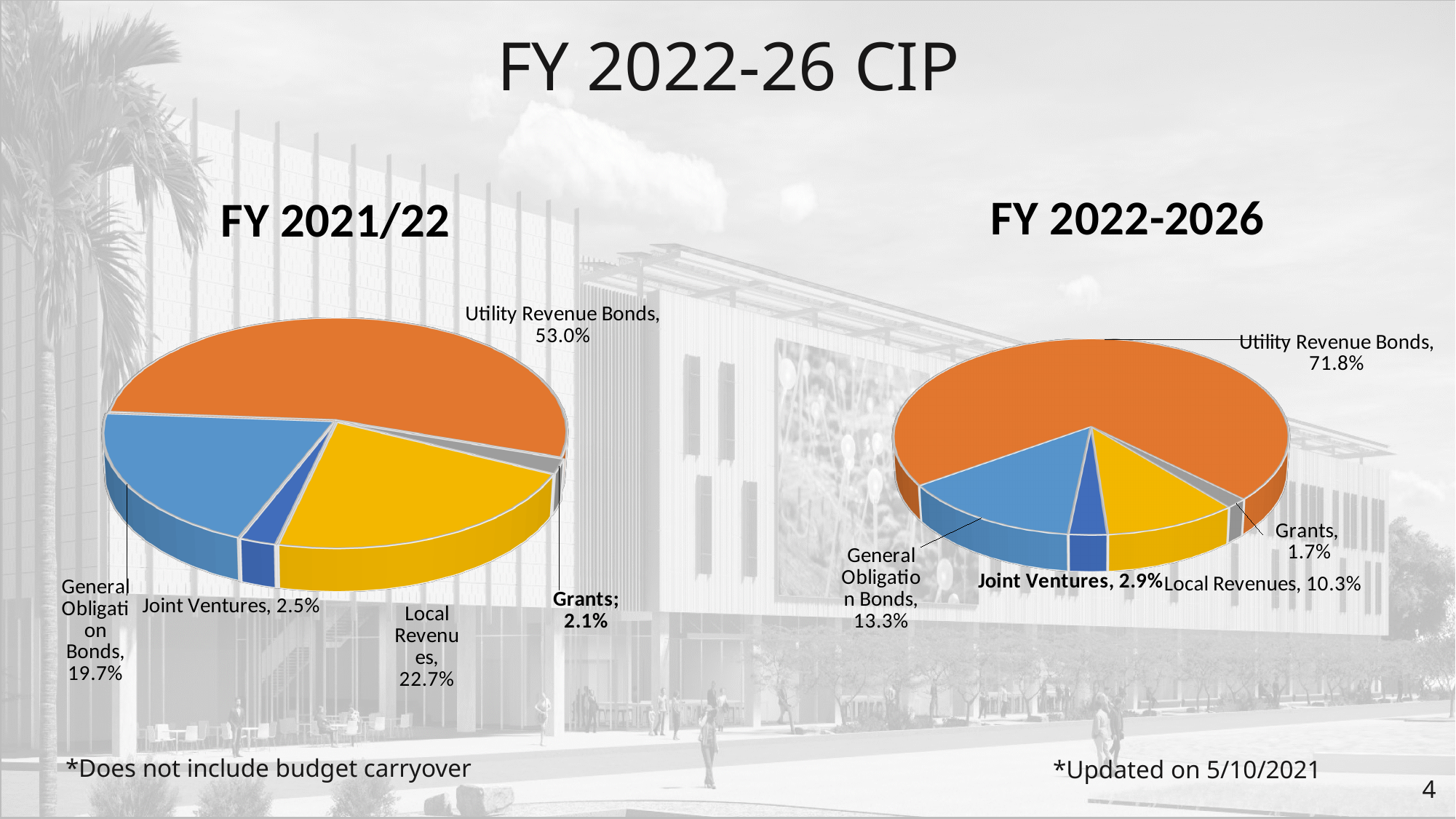
In the FY 2021/22 pie chart, what is the value for Local Revenues? 22.7% In the FY 2022-2026 pie chart, what is the value for Joint Ventures? 2.9% In the FY 2021/22 pie chart, which is larger, General Obligation Bonds or Local Revenues? Local Revenues What kind of chart is the FY 2021/22 chart? Pie chart How many categories are shown in the FY 2022-2026 pie chart? 5 In the FY 2021/22 pie chart, which category has the smallest share? Grants In the FY 2022-2026 pie chart, what share do Utility Revenue Bonds have? 71.8% In the FY 2021/22 pie chart, what colour is the Utility Revenue Bonds slice? Orange In the FY 2022-2026 pie chart, what is the value for General Obligation Bonds? 13.3% In the FY 2022-2026 pie chart, which category has the largest share? Utility Revenue Bonds In the FY 2022-2026 pie chart, what is the difference between Local Revenues and Grants? 8.6% In the FY 2021/22 pie chart, what share do Utility Revenue Bonds have? 53.0%